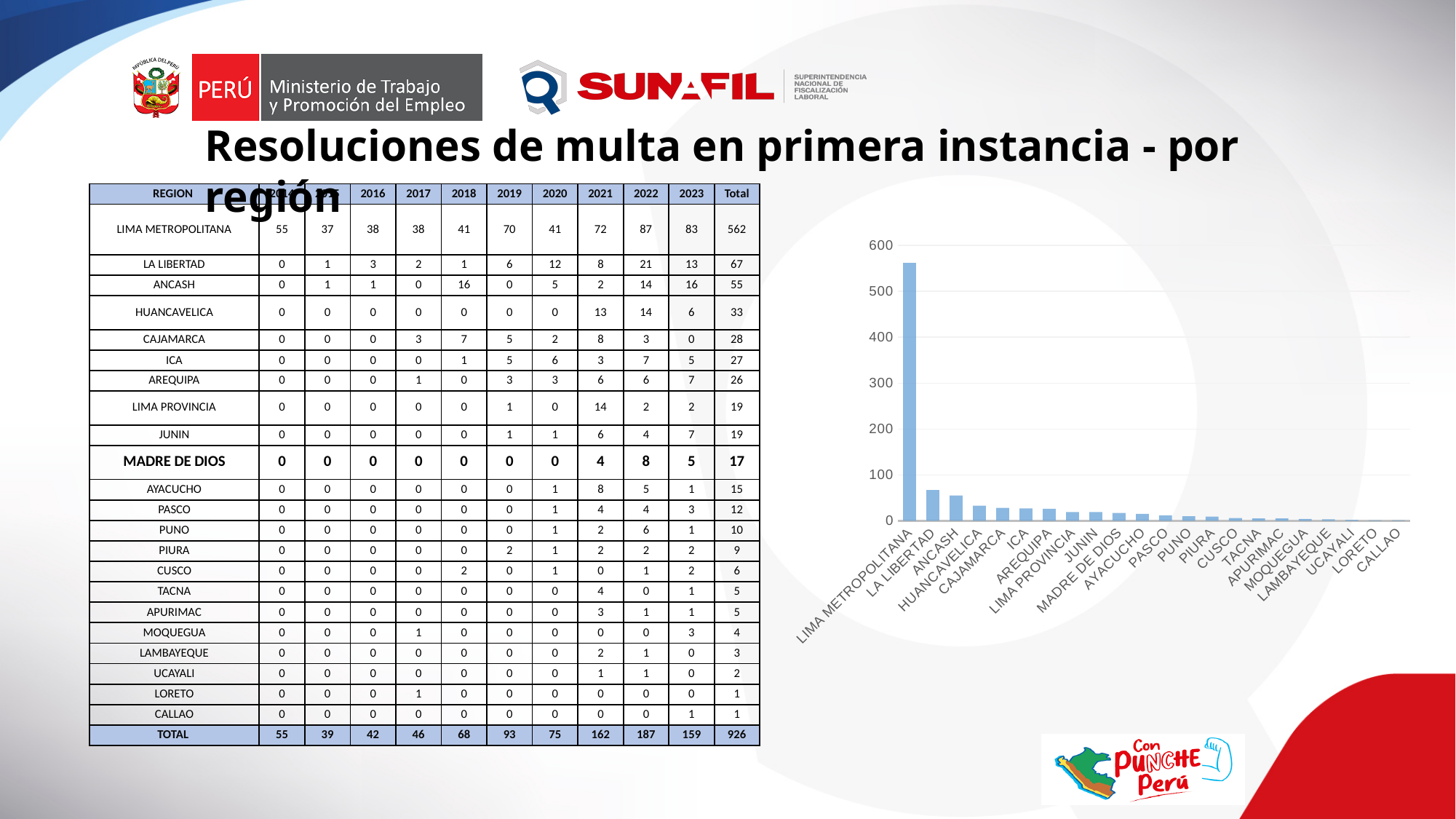
Is the value for LA LIBERTAD in the chart greater or less than 100? less Which is larger in the chart, the bar for LIMA METROPOLITANA or the bar for LA LIBERTAD? LIMA METROPOLITANA According to the table, what is the Total for LIMA METROPOLITANA, the value plotted in the chart? 562 What is the highest value shown on the chart's vertical axis? 600 Is the value for ANCASH in the chart greater or less than 100? less Using the Total values in the table, what is the difference between LIMA METROPOLITANA and LA LIBERTAD? 495 What kind of chart is shown on the right of the slide? bar chart Do the bar values rise or fall moving from left to right along the x axis? fall How many regions are plotted along the x axis of the chart? 22 Which region has the highest bar in the chart? LIMA METROPOLITANA Is the value for LIMA METROPOLITANA in the chart greater or less than 500? greater According to the table, what is the Total for LA LIBERTAD, the value plotted in the chart? 67